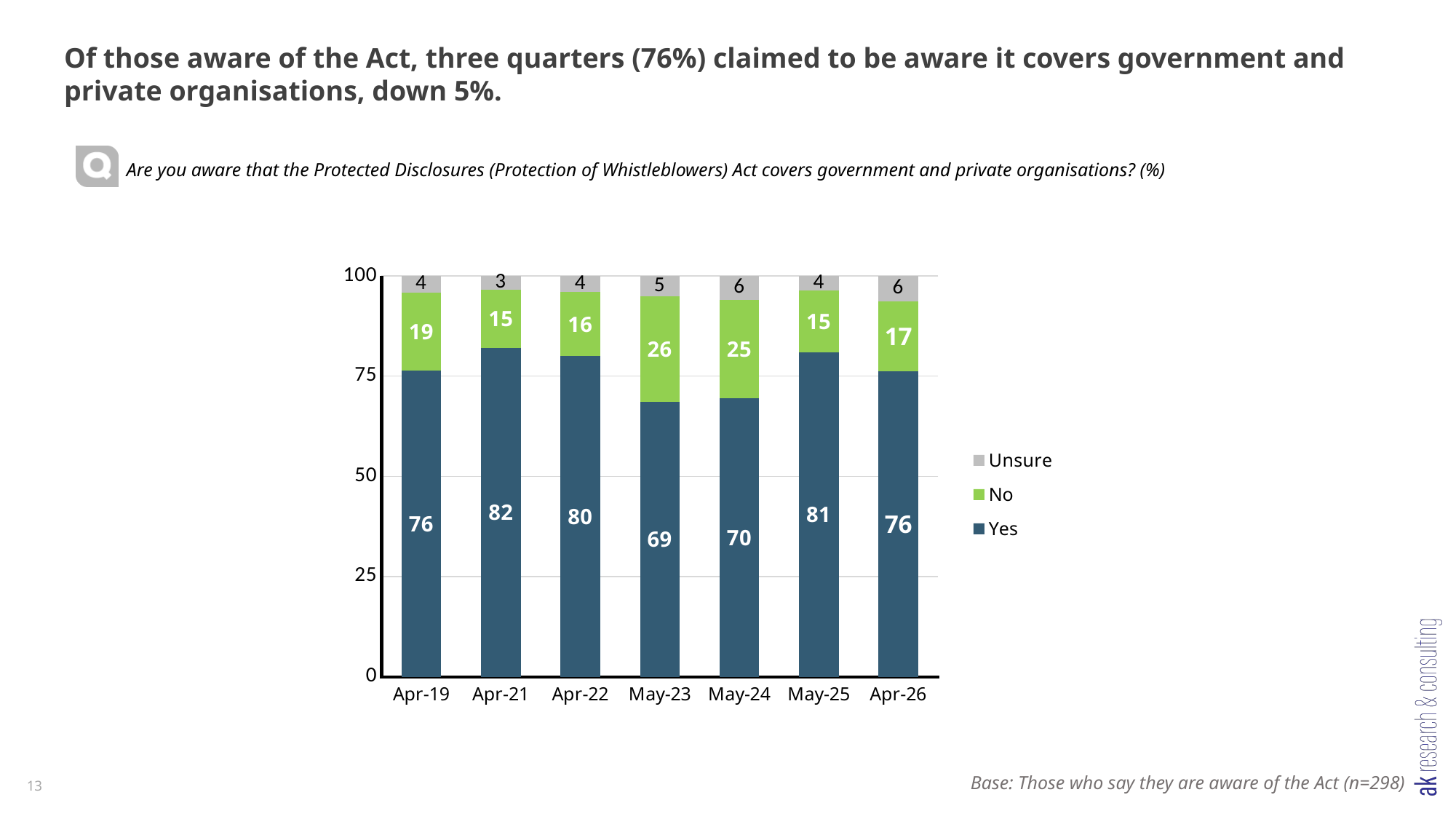
What is the difference between the Yes values for Apr-21 and May-23? 13 How many periods are shown on the x axis? 7 Which period has the lowest value for Yes? May-23 Which is larger, the No value for May-24 or the No value for May-25? May-24 What is the value for Yes in Apr-26? 76 How many series does the legend list? 3 What is the value for Unsure in Apr-21? 3 What kind of chart is shown on the slide? Stacked bar chart What is the value for No in May-23? 26 Which period has the highest value for Yes? Apr-21 What is the total of the stacked bar for May-25? 100 Which legend entry is shown in green? No